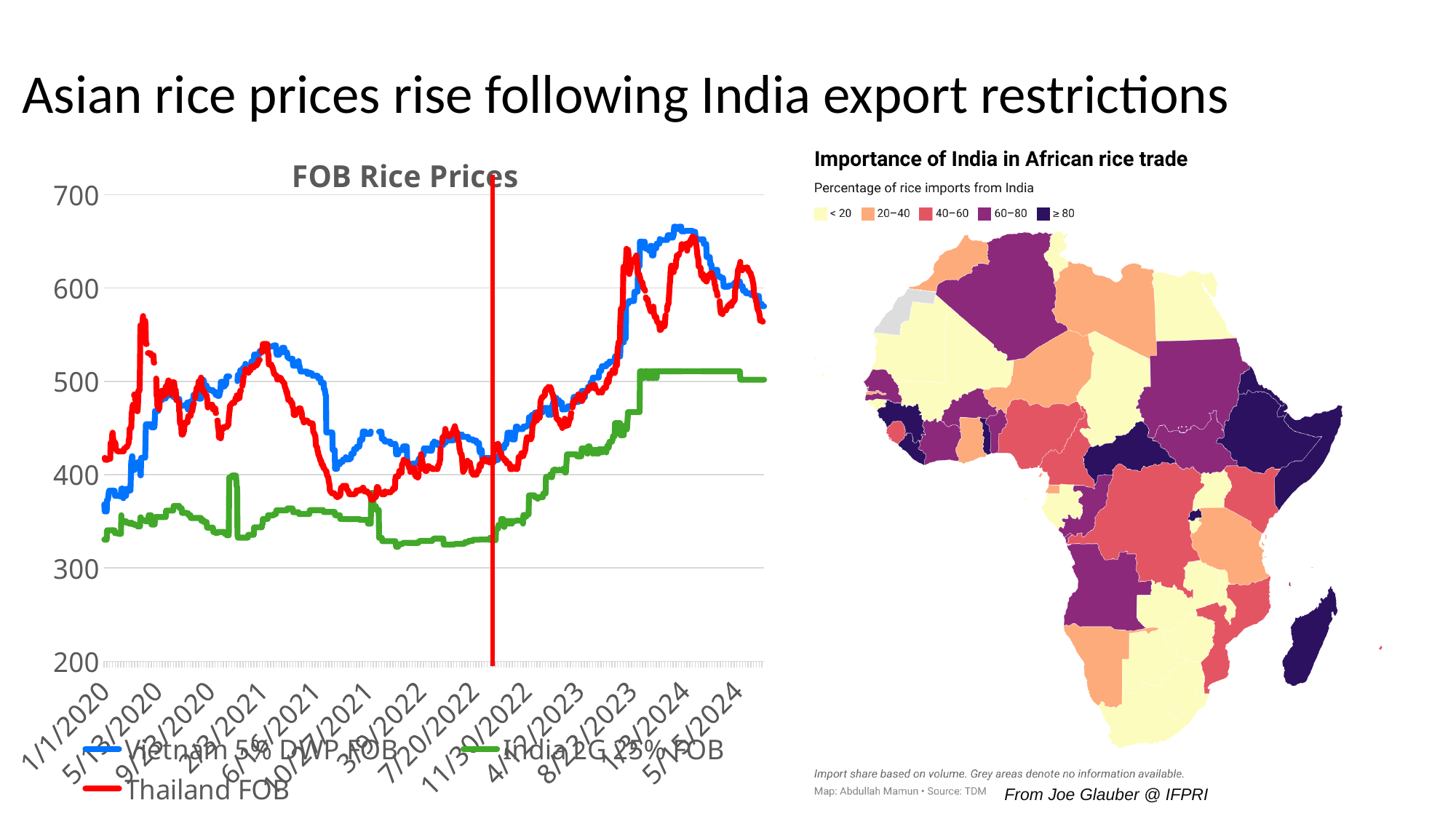
In the FOB Rice Prices chart, at the end of the period, which is higher: Vietnam 5% DWP FOB or India LG 25% FOB? Vietnam 5% DWP FOB In the FOB Rice Prices chart, which colour is used for the Thailand FOB series? red In the FOB Rice Prices chart, is the value for India LG 25% FOB at the end of the period (5/15/2024) greater or less than 400? greater In the FOB Rice Prices chart, is the peak value of the Vietnam 5% DWP FOB series greater or less than 600? greater What is the title of the line chart on the left of the slide? FOB Rice Prices In the FOB Rice Prices chart, does the India LG 25% FOB series rise or fall overall from the start to the end of the period? rise In the FOB Rice Prices chart, is the value for Vietnam 5% DWP FOB at 1/1/2020 greater or less than 400? less What kind of chart is the FOB Rice Prices chart? line chart How many series does the legend of the FOB Rice Prices chart list? 3 In the FOB Rice Prices chart, which series has the lowest values during 2022? India LG 25% FOB